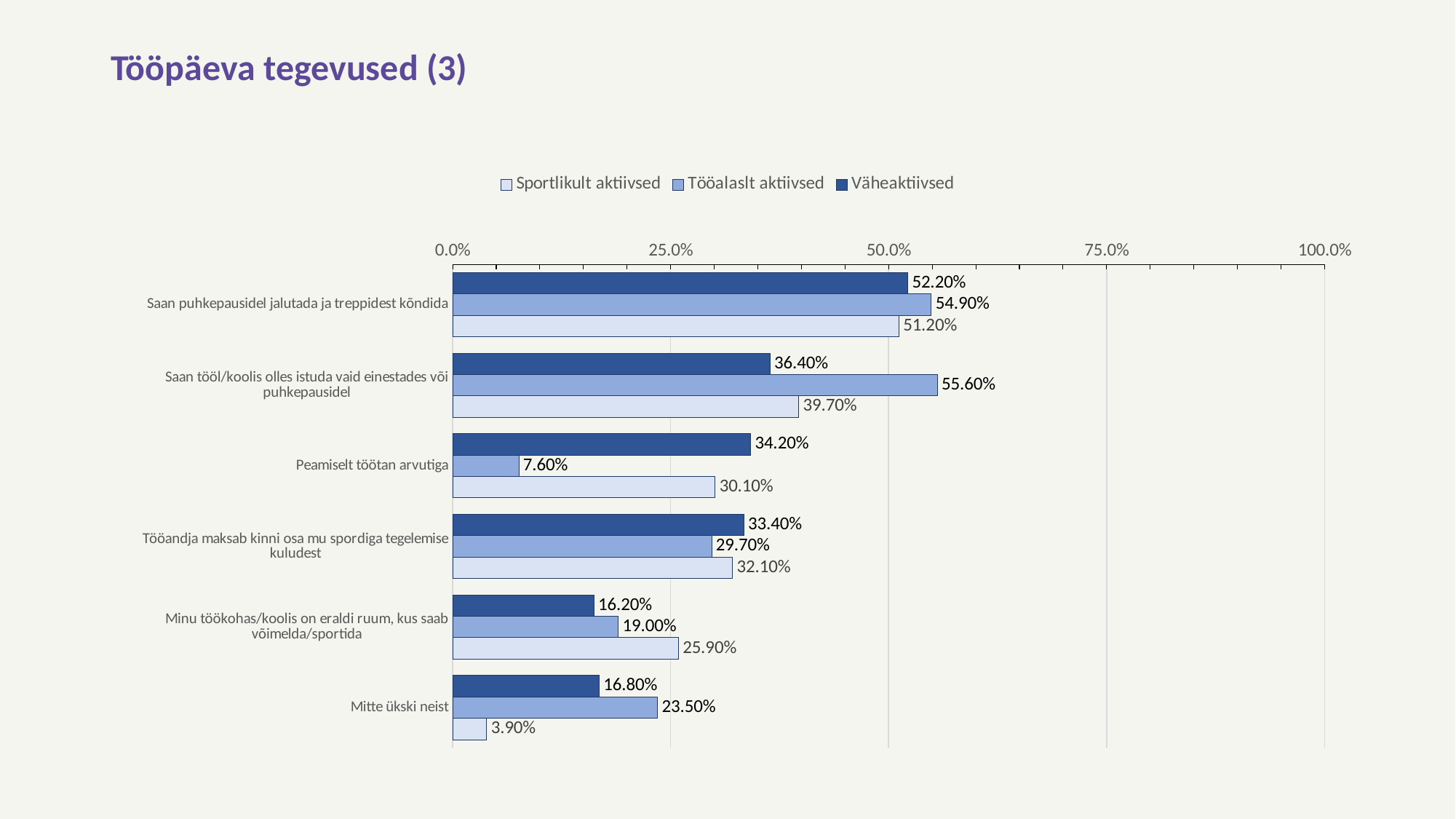
Which category has the lowest value for Tööalaslt aktiivsed? Peamiselt töötan arvutiga What is the value for Sportlikult aktiivsed in the category 'Mitte ükski neist'? 3.90% What type of chart is shown on the slide? Bar chart In the category 'Minu töökohas/koolis on eraldi ruum, kus saab võimelda/sportida', which series has the larger value: Sportlikult aktiivsed or Väheaktiivsed? Sportlikult aktiivsed How many categories are shown on the chart? 6 What is the value for Väheaktiivsed in the category 'Peamiselt töötan arvutiga'? 34.20% Is the value for Tööalaslt aktiivsed in the category 'Saan puhkepausidel jalutada ja treppidest kõndida' greater or less than 50.0%? greater Which category has the highest value for Sportlikult aktiivsed? Saan puhkepausidel jalutada ja treppidest kõndida What is the difference between the Tööalaslt aktiivsed and Väheaktiivsed values in the category 'Saan tööl/koolis olles istuda vaid einestades või puhkepausidel'? 19.20% What is the title of the slide? Tööpäeva tegevused (3) What is the value for Tööalaslt aktiivsed in the category 'Saan tööl/koolis olles istuda vaid einestades või puhkepausidel'? 55.60% How many series does the legend list? 3